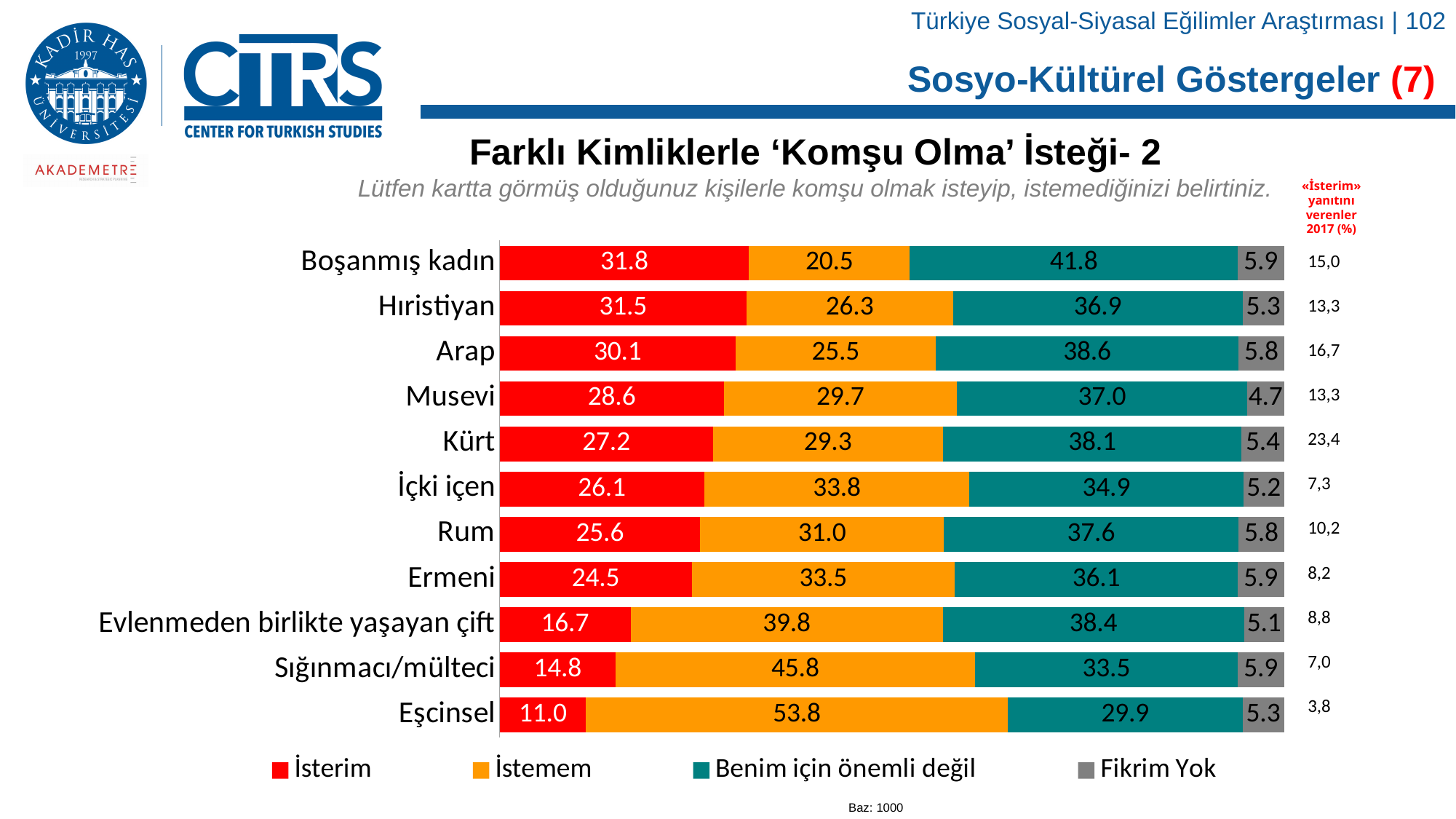
What is the 'İsterim' value for Boşanmış kadın? 31.8 How many series does the legend list? 4 Which category has the lowest 'Fikrim Yok' value? Musevi How many categories are shown in the chart? 11 What is the 'Fikrim Yok' value for Kürt? 5.4 Which category has the highest 'İstemem' value? Eşcinsel Which has the larger 'İsterim' value, Kürt or Rum? Kürt Which category has the lowest 'İsterim' value? Eşcinsel What is the 'İstemem' value for Sığınmacı/mülteci? 45.8 What is the 'Benim için önemli değil' value for Musevi? 37.0 What is the difference between the 'İstemem' and 'İsterim' values for Eşcinsel? 42.8 What kind of chart is shown on the slide? Stacked bar chart